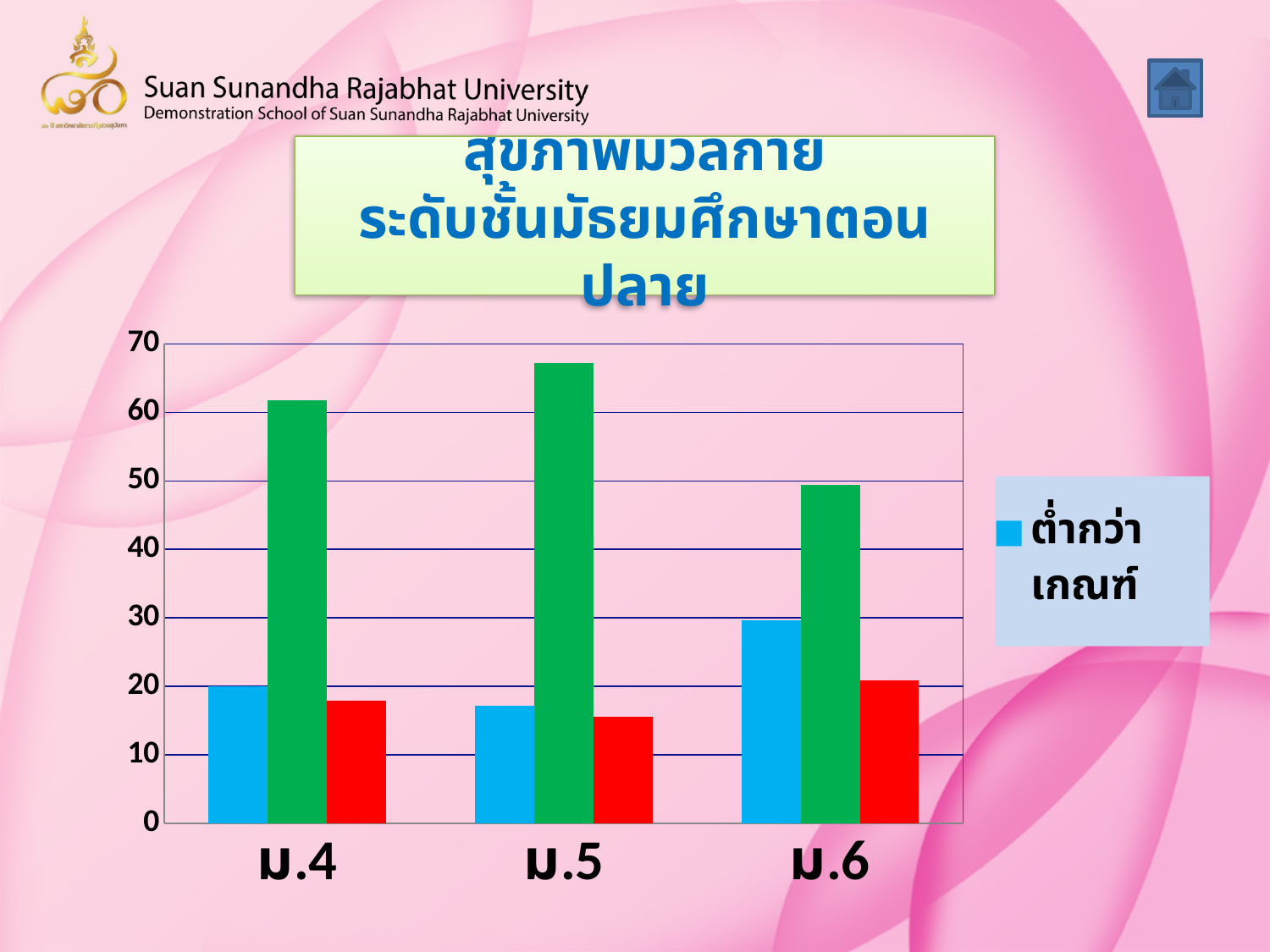
Which category has the shortest ต่ำกว่าเกณฑ์ (blue) bar? ม.5 What kind of chart is shown on the slide? bar chart What legend entry is shown for the blue series? ต่ำกว่าเกณฑ์ Which is larger, the green bar for ม.4 or the green bar for ม.6? ม.4 Which category has the tallest ต่ำกว่าเกณฑ์ (blue) bar? ม.6 How many categories are shown on the x axis of the chart? 3 What is the value of the ต่ำกว่าเกณฑ์ (blue) bar for ม.4? 20 Does the green bar rise or fall from ม.5 to ม.6? fall Is the red bar for ม.4 greater or less than 20? less Which category has the tallest green bar? ม.5 Is the green bar for ม.5 greater or less than 60? greater Is the ต่ำกว่าเกณฑ์ (blue) bar for ม.6 greater or less than 20? greater